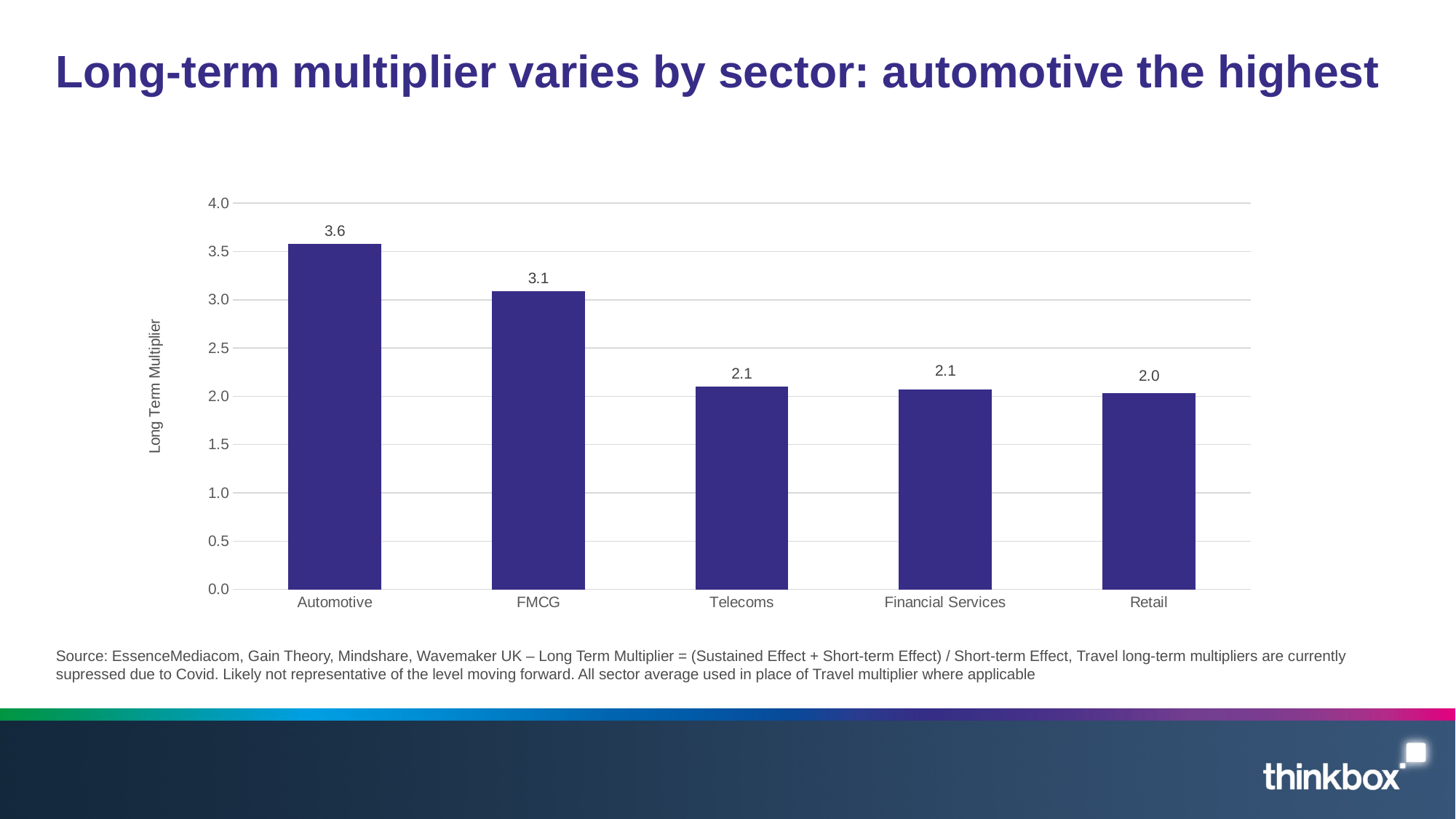
What is the label on the vertical axis of the chart? Long Term Multiplier What is the long-term multiplier for Automotive? 3.6 Is the value for Automotive greater or less than 3.5? greater Which sector has the highest long-term multiplier? Automotive What is the long-term multiplier for Telecoms? 2.1 Which has a larger long-term multiplier, FMCG or Telecoms? FMCG What is the long-term multiplier for Retail? 2.0 Which sector has the lowest long-term multiplier? Retail What is the difference between the long-term multipliers for Automotive and FMCG? 0.5 How many sectors are shown in the chart? 5 What kind of chart is shown on the slide? Bar chart What is the long-term multiplier for FMCG? 3.1